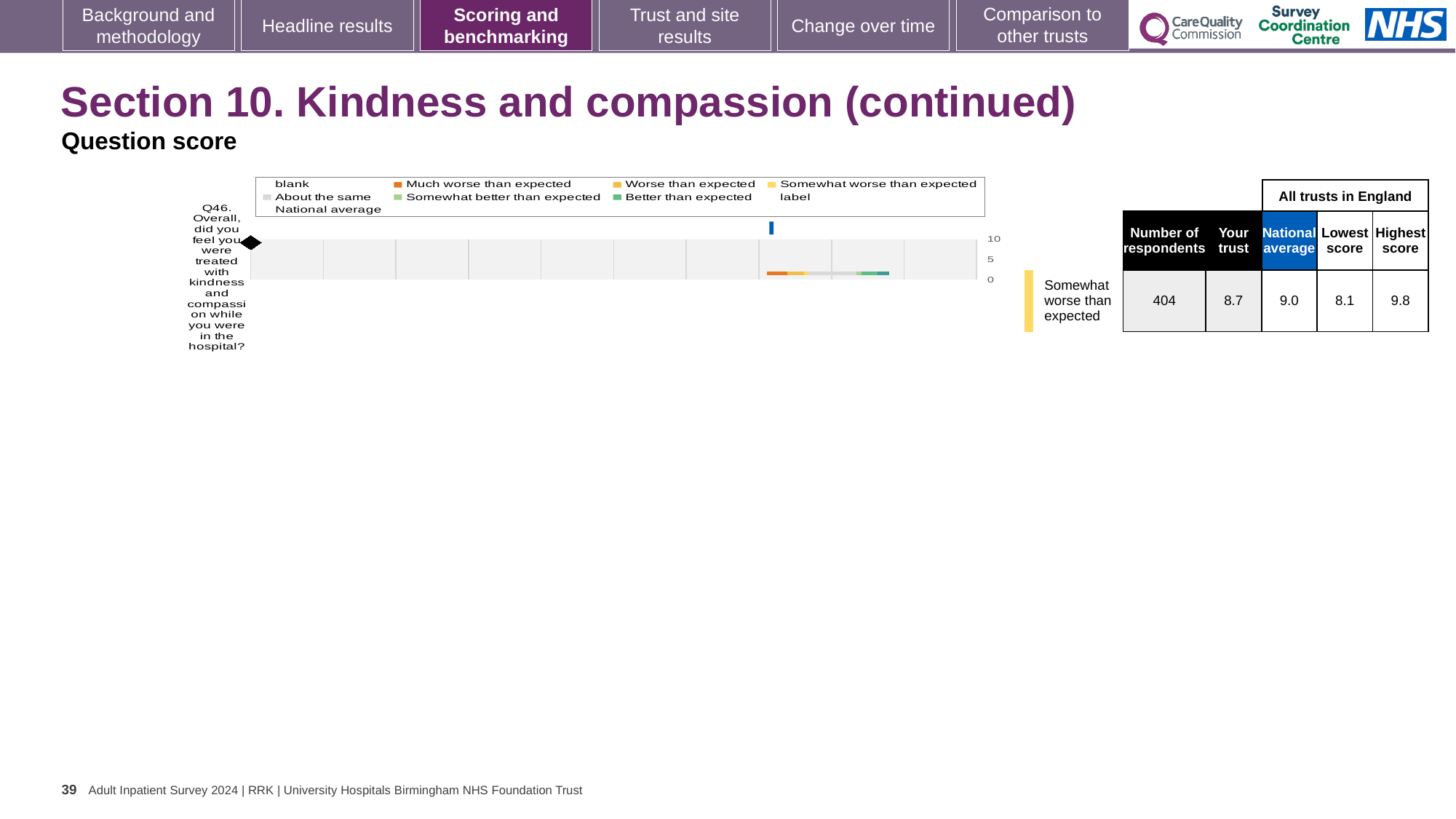
Which benchmarking category is the trust's Q46 result assigned to? Somewhat worse than expected By how much does the national average exceed the 'Your trust' score for Q46? 0.3 Which is larger for Q46: the 'Your trust' score or the national average? National average What is the lowest score among all trusts in England for Q46? 8.1 What is the difference between the highest score and the lowest score for Q46? 1.7 What kind of chart is shown on the slide for Q46? bar chart What is the highest score among all trusts in England for Q46? 9.8 What is the 'Your trust' score for Q46 shown alongside the chart? 8.7 What is the national average score for Q46? 9.0 How many respondents answered Q46? 404 What is the highest tick value shown on the chart's score axis? 10 How many questions are plotted on the chart? 1